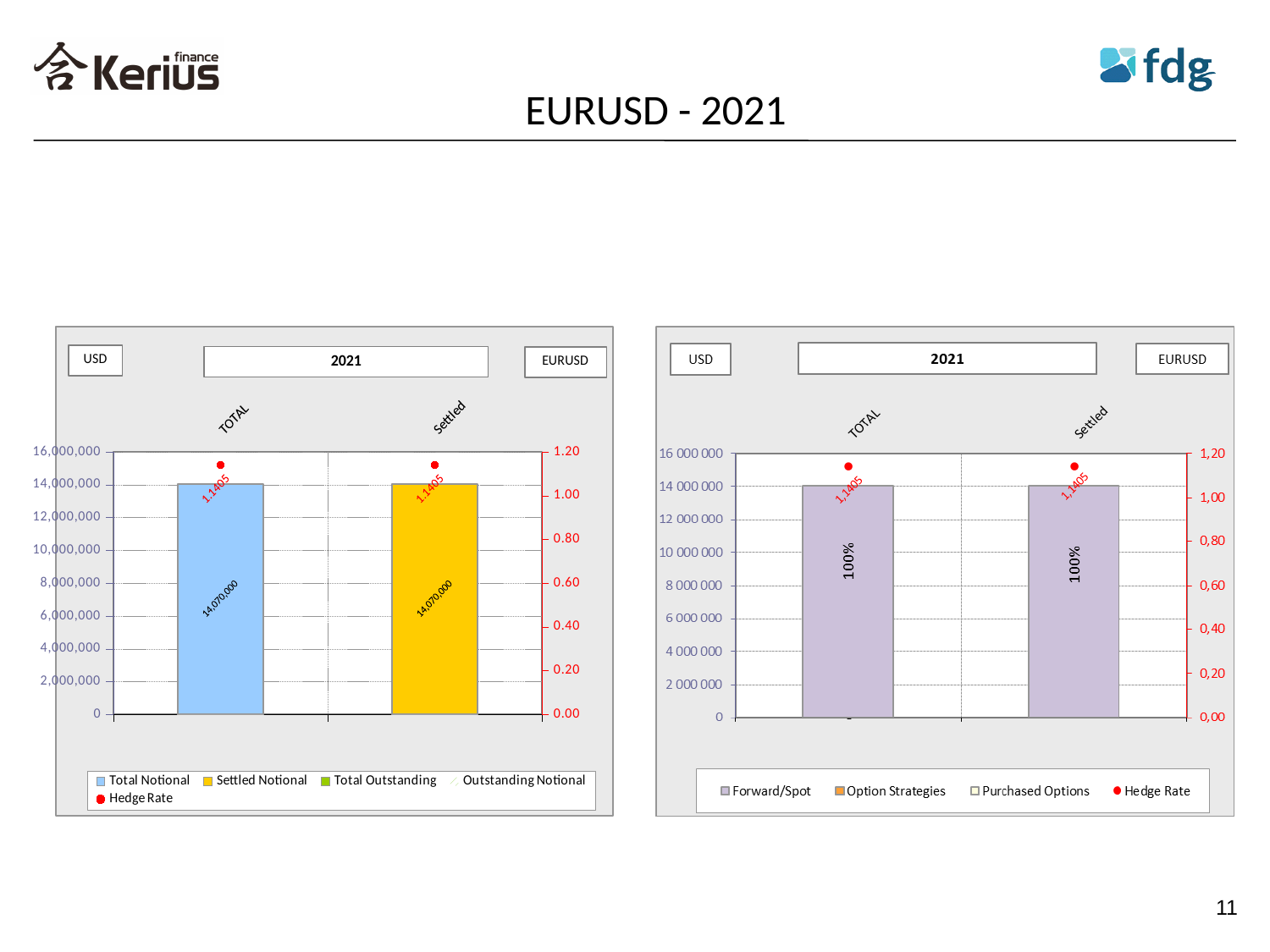
In the right chart, what percentage label is shown on the Settled bar? 100% In the right chart, what is the Hedge Rate value shown for Settled? 1,1405 In the right chart, how many categories are shown on the x axis? 2 In the left chart, how many entries does the legend list? 5 In the right chart, how many entries does the legend list? 4 In the right chart, what percentage label is shown on the TOTAL bar? 100% In the left chart, what colour is the Settled Notional bar? Yellow In the left chart, what is the data label on the Settled bar? 14,070,000 In the left chart, what is the data label on the TOTAL bar? 14,070,000 In the left chart, is the value for the TOTAL bar greater or less than 12,000,000? greater In the left chart, what is the Hedge Rate value shown for TOTAL? 1.1405 What kind of chart is the left chart? Bar chart with a line/marker series